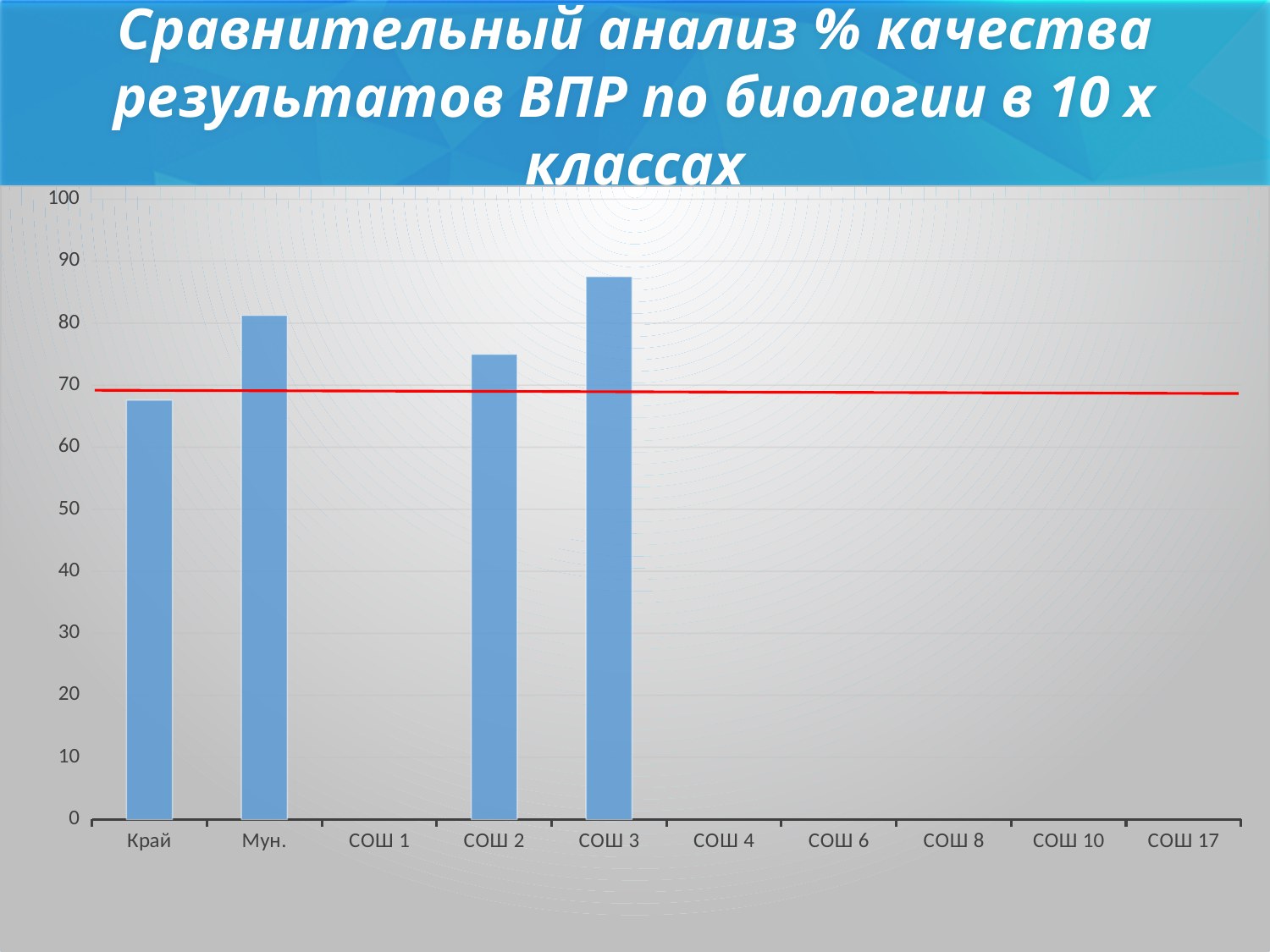
Which is larger, the value for Край or the value for СОШ 2? СОШ 2 Is the value for СОШ 3 greater or less than 80? greater How many categories have a visible bar plotted? 4 Among the categories with a plotted bar, which has the lowest value? Край What colour is the horizontal reference line drawn across the chart? red Which category has the highest bar? СОШ 3 Is the value for Мун. greater or less than 70? greater What kind of chart is shown on the slide? bar chart How many categories are listed along the x axis? 10 Is the value for Край greater or less than 70? less Which is larger, the value for Мун. or the value for СОШ 2? Мун.